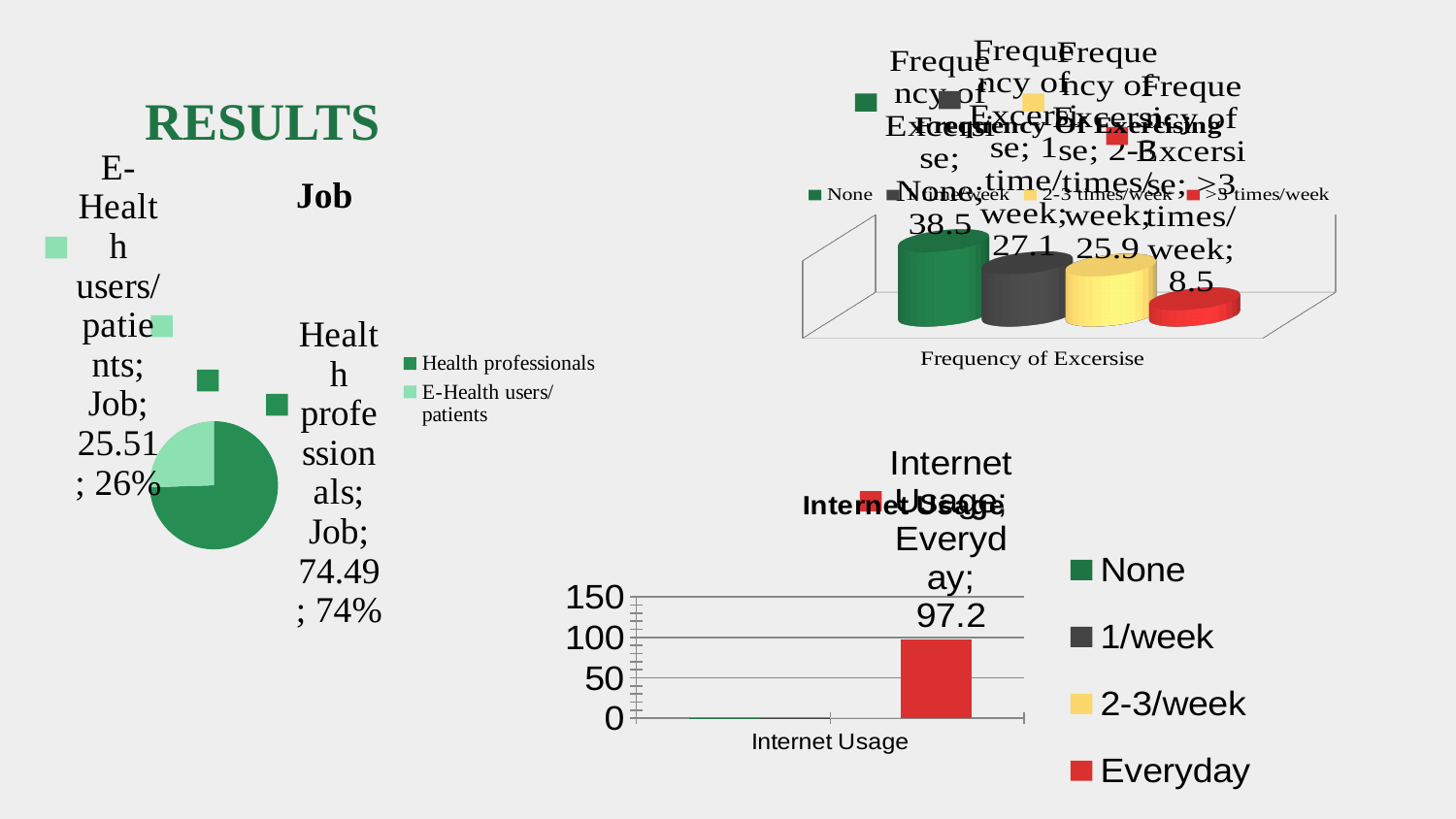
In the Job pie chart, which category has the larger share? Health professionals In the Frequency of Excersise chart, which category has the lowest value? >3 times/week In the Frequency of Excersise chart, what is the value for None? 38.5 In the Job pie chart, what value is shown for Health professionals? 74.49 How many series does the legend of the Internet Usage chart list? 4 In the Internet Usage chart, what is the value for Everyday? 97.2 In the Frequency of Excersise chart, what is the difference between None and 1/week? 11.4 In the Frequency of Excersise chart, what is the value for 2-3 times/week? 25.9 In the Internet Usage chart, is the value for Everyday greater or less than 50? greater In the Frequency of Excersise chart, how many bars are plotted? 4 In the Job pie chart, what percentage share do E-Health users/patients have? 26% What kind of chart is the Job chart? pie chart